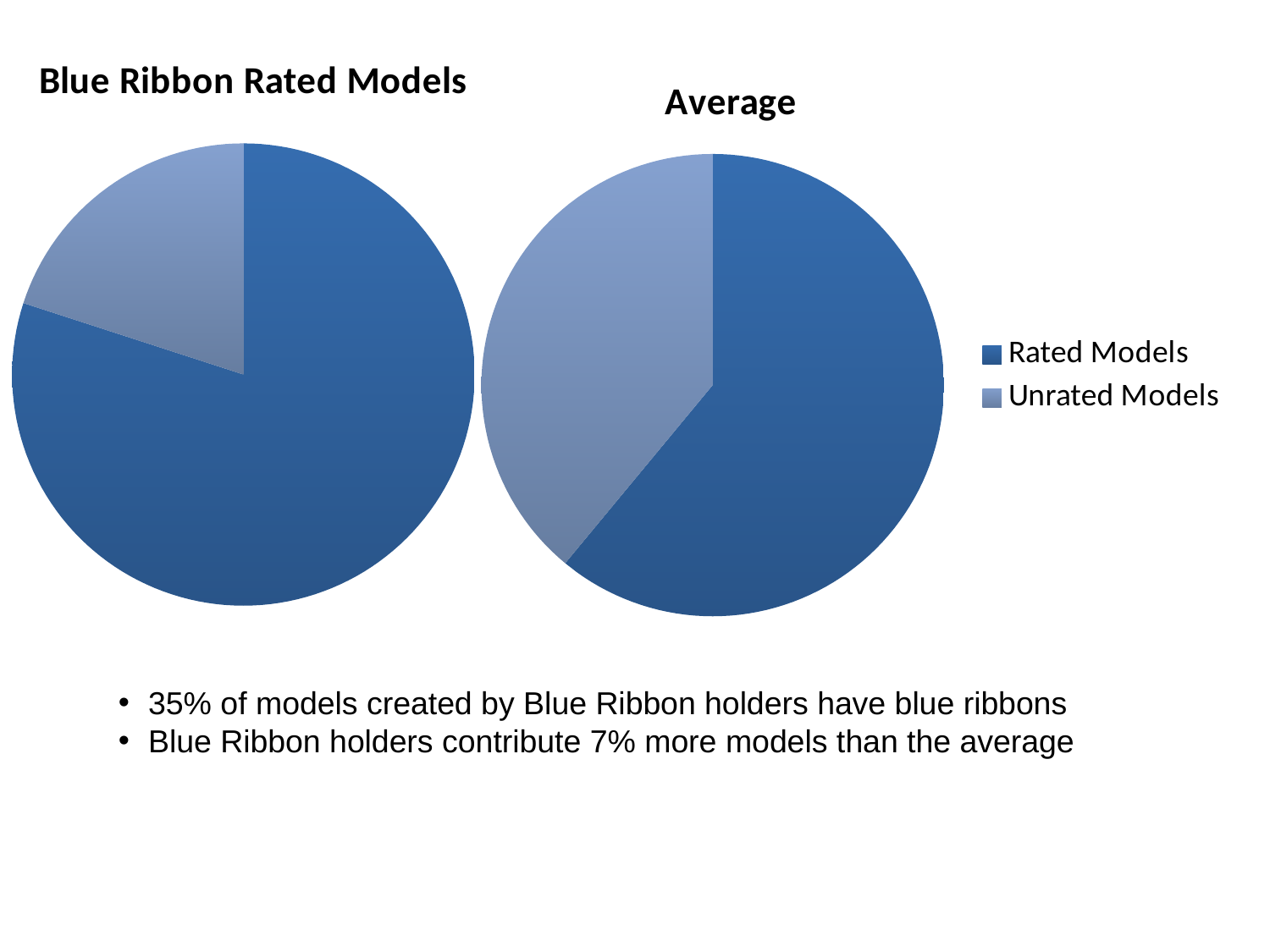
Which legend entry is shown in the lighter blue colour? Unrated Models How many slices does the "Blue Ribbon Rated Models" pie chart have? 2 In the "Average" chart, which slice is the largest? Rated Models In the "Blue Ribbon Rated Models" chart, which slice is the largest? Rated Models In the "Blue Ribbon Rated Models" chart, which slice is the smallest? Unrated Models Which chart has the larger Unrated Models slice, "Blue Ribbon Rated Models" or "Average"? Average What is the title of the pie chart on the left? Blue Ribbon Rated Models What kind of chart is the "Blue Ribbon Rated Models" chart? pie chart How many entries does the legend list? 2 What kind of chart is the "Average" chart? pie chart How many slices does the "Average" pie chart have? 2 In the "Average" chart, which slice is the smallest? Unrated Models